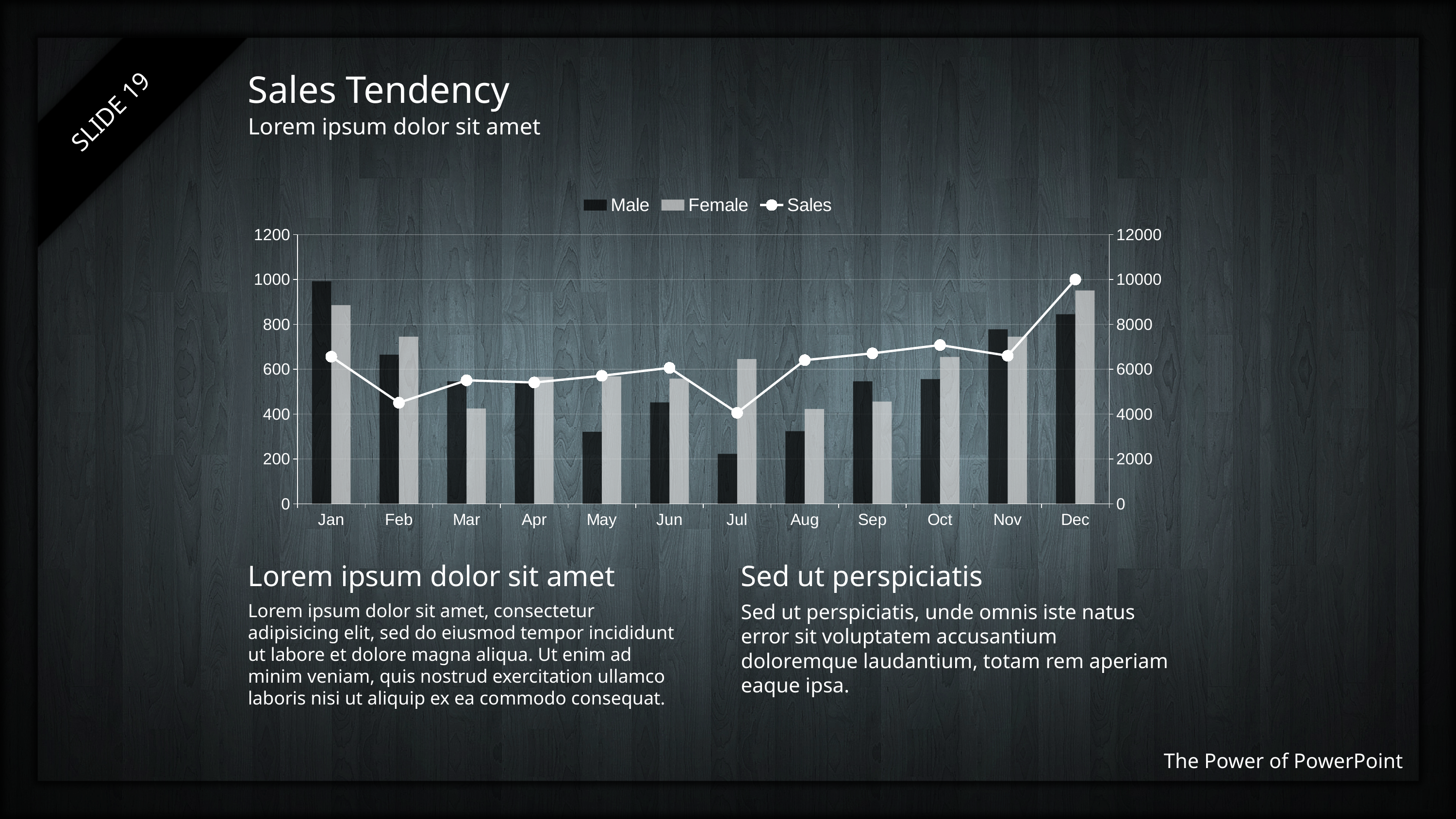
Is the Sales value for Jul greater or less than 6000? less In Feb, which is larger, the Male value or the Female value? Female Which month has the lowest Sales value? Jul Which month has the highest Male value? Jan Which month has the lowest Male value? Jul What is the title of the chart? Sales Tendency How many months are shown on the x axis? 12 Do the Sales values rise or fall from Jul to Oct? rise Which series is plotted as a line rather than bars? Sales How many series does the legend list? 3 Is the Male value for Jan greater or less than 800? greater Which month has the highest Sales value? Dec